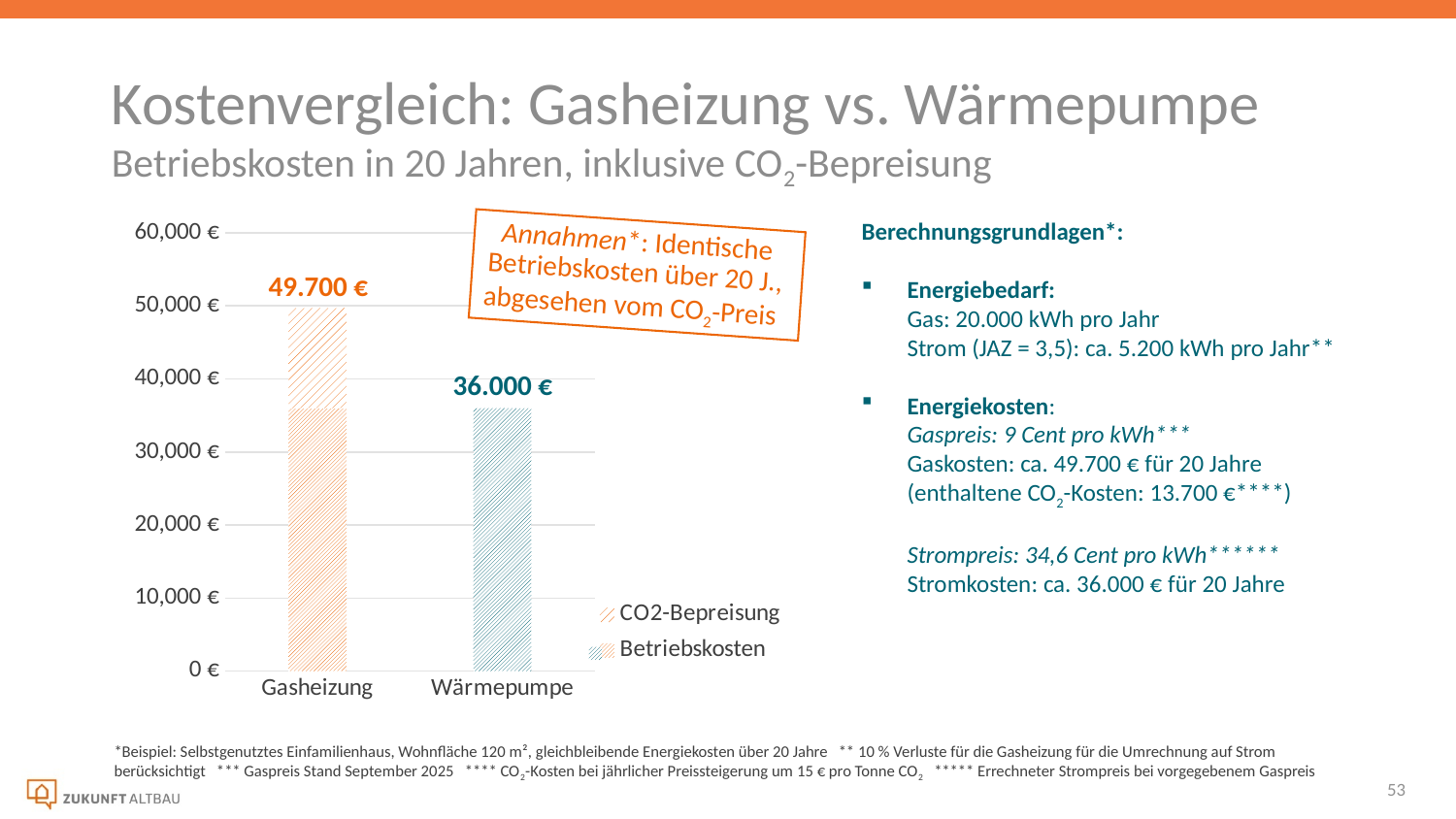
What is the difference between the total for Gasheizung and the total for Wärmepumpe? 13.700 € How many series does the chart legend list? 2 Is the total value for Wärmepumpe greater or less than 40,000 €? less Which category has the higher total cost, Gasheizung or Wärmepumpe? Gasheizung Which series in the legend appears only in the Gasheizung bar? CO2-Bepreisung Is the Betriebskosten portion of the Gasheizung bar greater or less than 30,000 €? greater What is the total value shown for Gasheizung? 49.700 € Which category has the lowest total value in the chart? Wärmepumpe What is the total value shown for Wärmepumpe? 36.000 € Is the total value for Gasheizung greater or less than 40,000 €? greater What kind of chart is shown on the slide? Stacked bar chart How many categories are shown on the x axis of the chart? 2